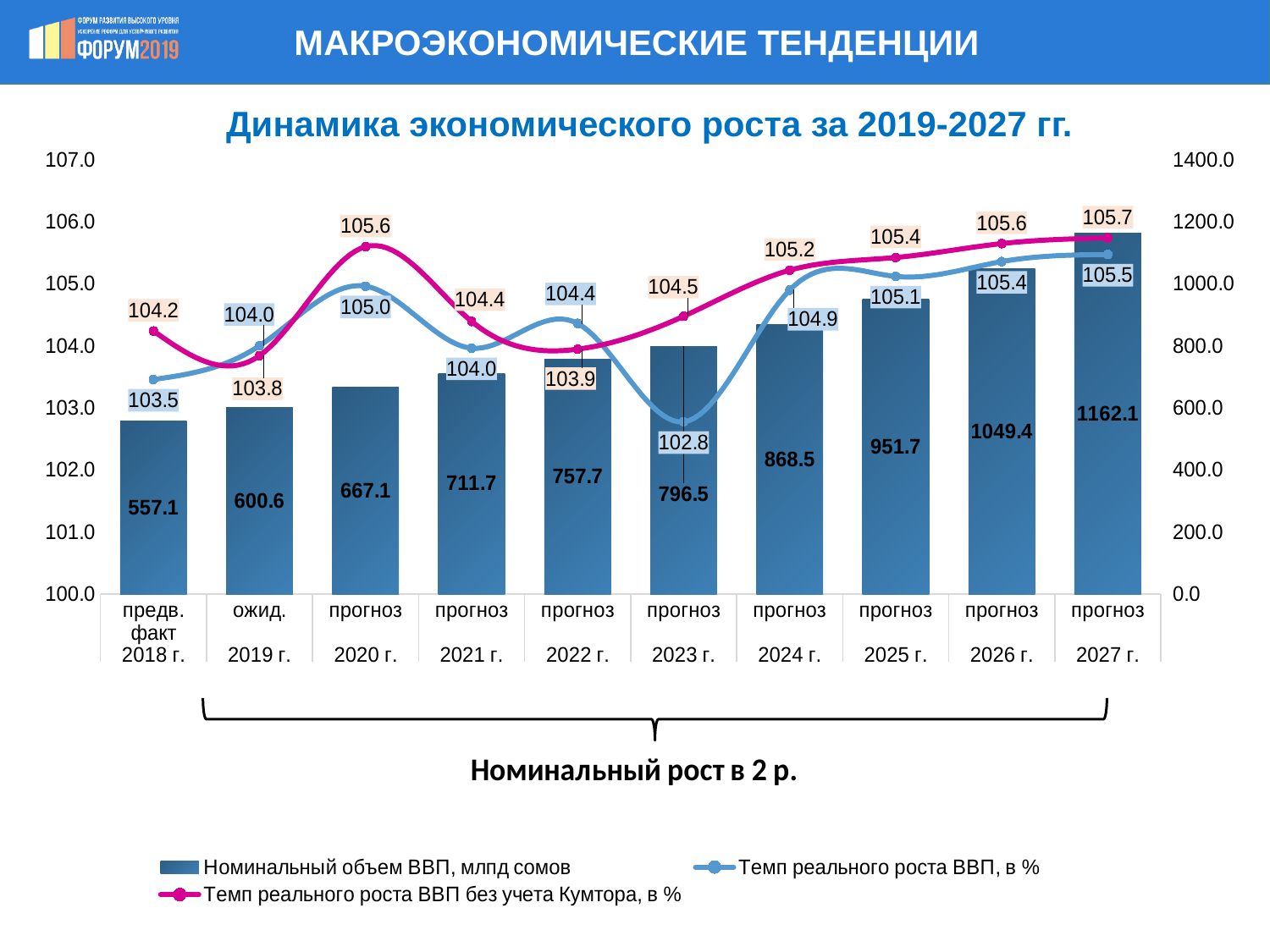
What is the value of Темп реального роста ВВП без учета Кумтора, в % for 2020 г.? 105.6 What is the difference between the nominal GDP for 2027 г. and 2018 г.? 605.0 For 2020 г., which is larger: Темп реального роста ВВП, в % or Темп реального роста ВВП без учета Кумтора, в %? Темп реального роста ВВП без учета Кумтора, в % How many series does the legend list? 3 What kind of chart is this? Combined bar and line chart How many years are shown on the x axis? 10 Do the nominal GDP bars rise or fall from 2018 г. to 2027 г.? Rise What is the value of Темп реального роста ВВП, в % for 2023 г.? 102.8 In which year is Темп реального роста ВВП, в % at its lowest? 2023 г. What is the nominal GDP value (Номинальный объем ВВП) shown for 2027 г.? 1162.1 Which year has the highest nominal GDP bar? 2027 г. What is the title of the chart? Динамика экономического роста за 2019-2027 гг.